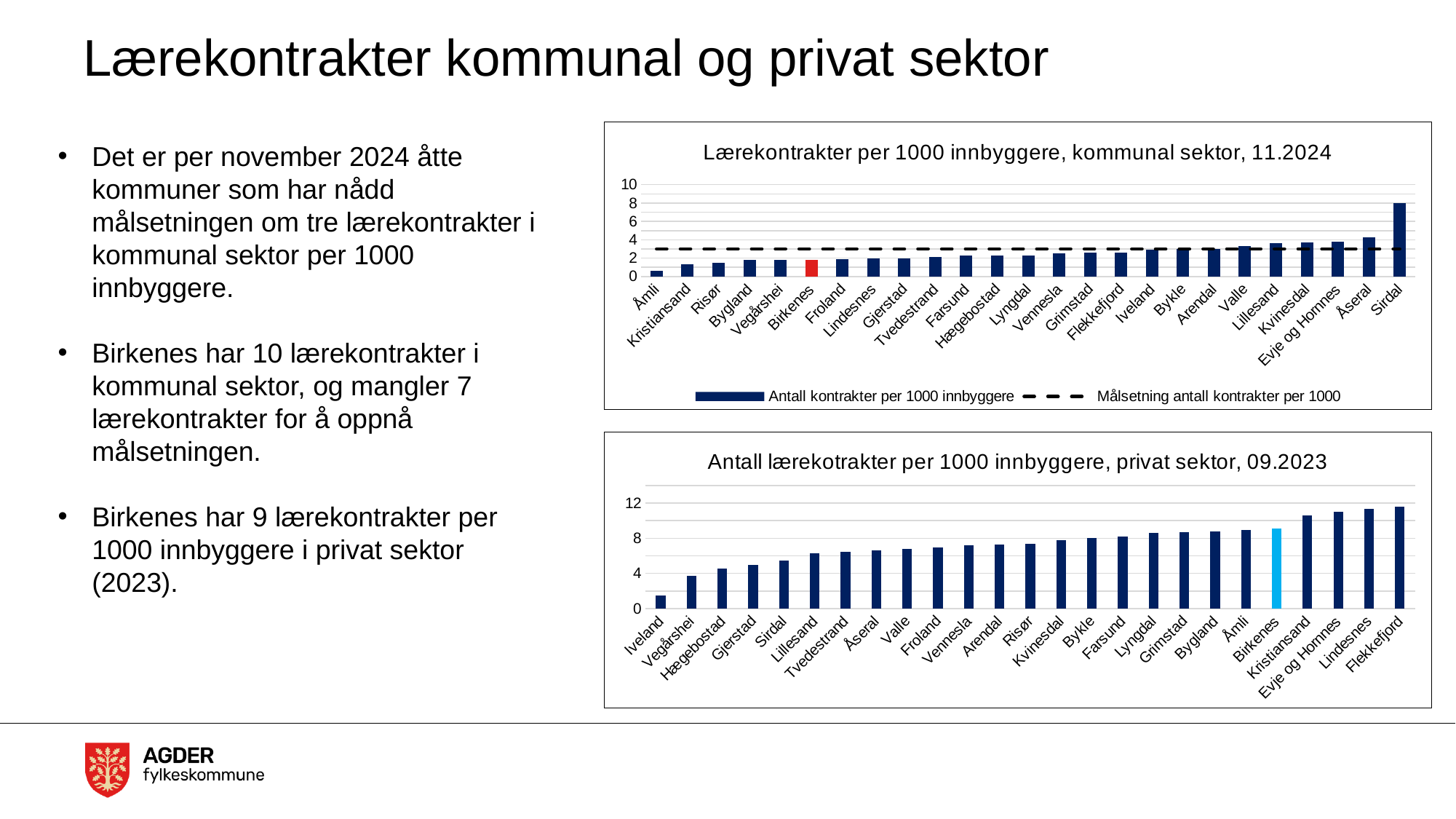
In the bottom chart (privat sektor, 09.2023), which municipality has the lowest value? Iveland In the bottom chart (privat sektor, 09.2023), is the value for Birkenes greater or less than 8? greater In the bottom chart (privat sektor, 09.2023), which municipality has the highest value? Flekkefjord In the top chart (kommunal sektor, 11.2024), how many entries does the legend list? 2 In the top chart (kommunal sektor, 11.2024), which municipality has the highest value? Sirdal In the top chart (kommunal sektor, 11.2024), which municipality has the lowest value? Åmli In the top chart (kommunal sektor, 11.2024), is the value for Sirdal greater or less than 6? greater In the bottom chart (privat sektor, 09.2023), which is larger, the value for Kristiansand or the value for Vegårshei? Kristiansand In the top chart (kommunal sektor, 11.2024), do the bar values rise or fall from left to right along the x axis? Rise What type of chart is the top chart, 'Lærekontrakter per 1000 innbyggere, kommunal sektor, 11.2024'? Bar chart In the top chart (kommunal sektor, 11.2024), how many municipalities are shown on the x axis? 25